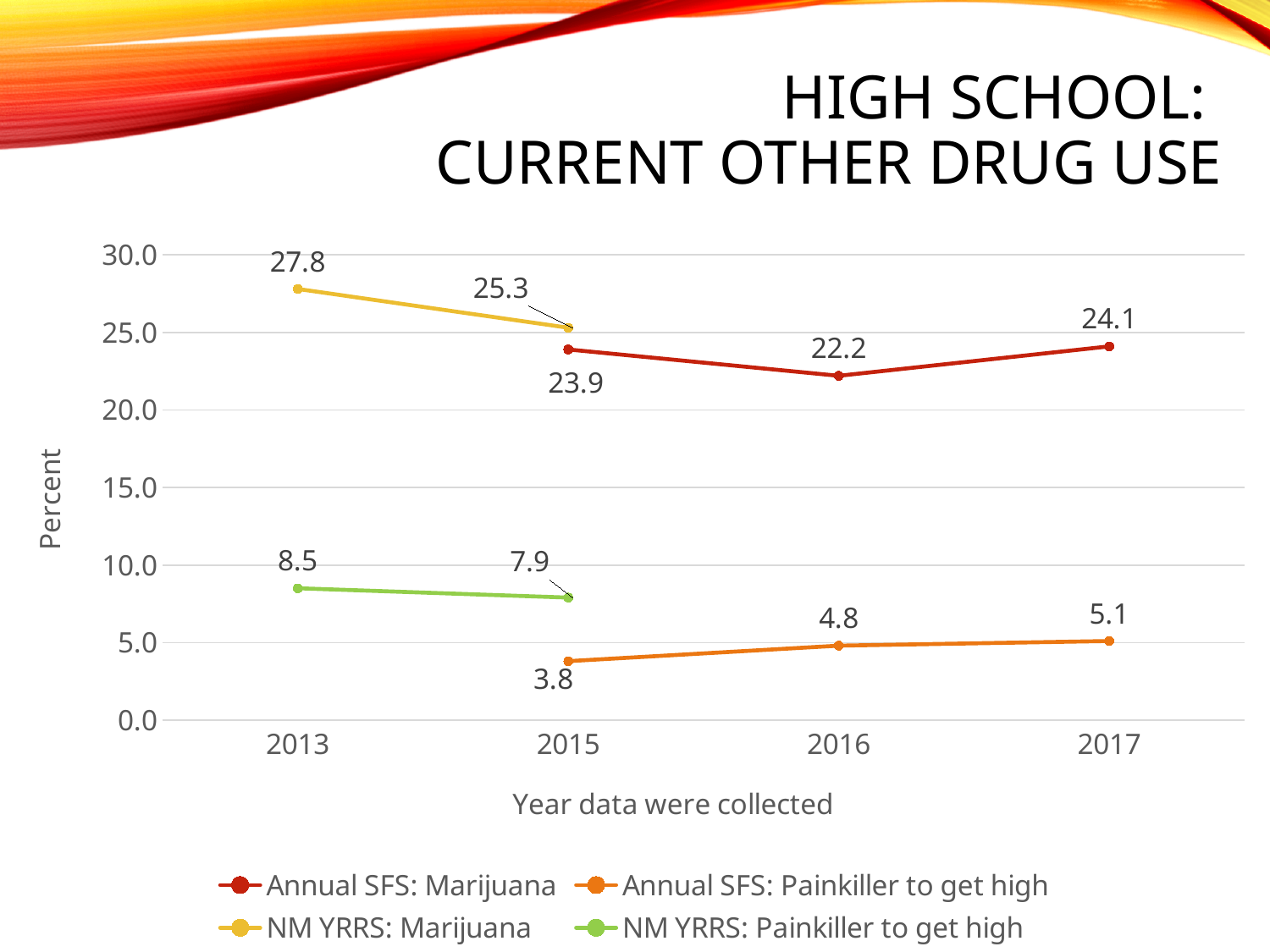
What is the label of the y axis? Percent In which year is Annual SFS: Painkiller to get high lowest? 2015 What is the difference between NM YRRS: Marijuana in 2013 and in 2015? 2.5 How many series does the legend list? 4 Which is larger in 2015: Annual SFS: Marijuana or NM YRRS: Marijuana? NM YRRS: Marijuana What is the value for Annual SFS: Marijuana in 2016? 22.2 What is the value for Annual SFS: Painkiller to get high in 2015? 3.8 In which year is Annual SFS: Marijuana highest? 2017 What is the value for NM YRRS: Painkiller to get high in 2015? 7.9 What is the value for NM YRRS: Marijuana in 2013? 27.8 What kind of chart is shown on the slide? Line chart Does Annual SFS: Painkiller to get high rise or fall from 2015 to 2017? Rise